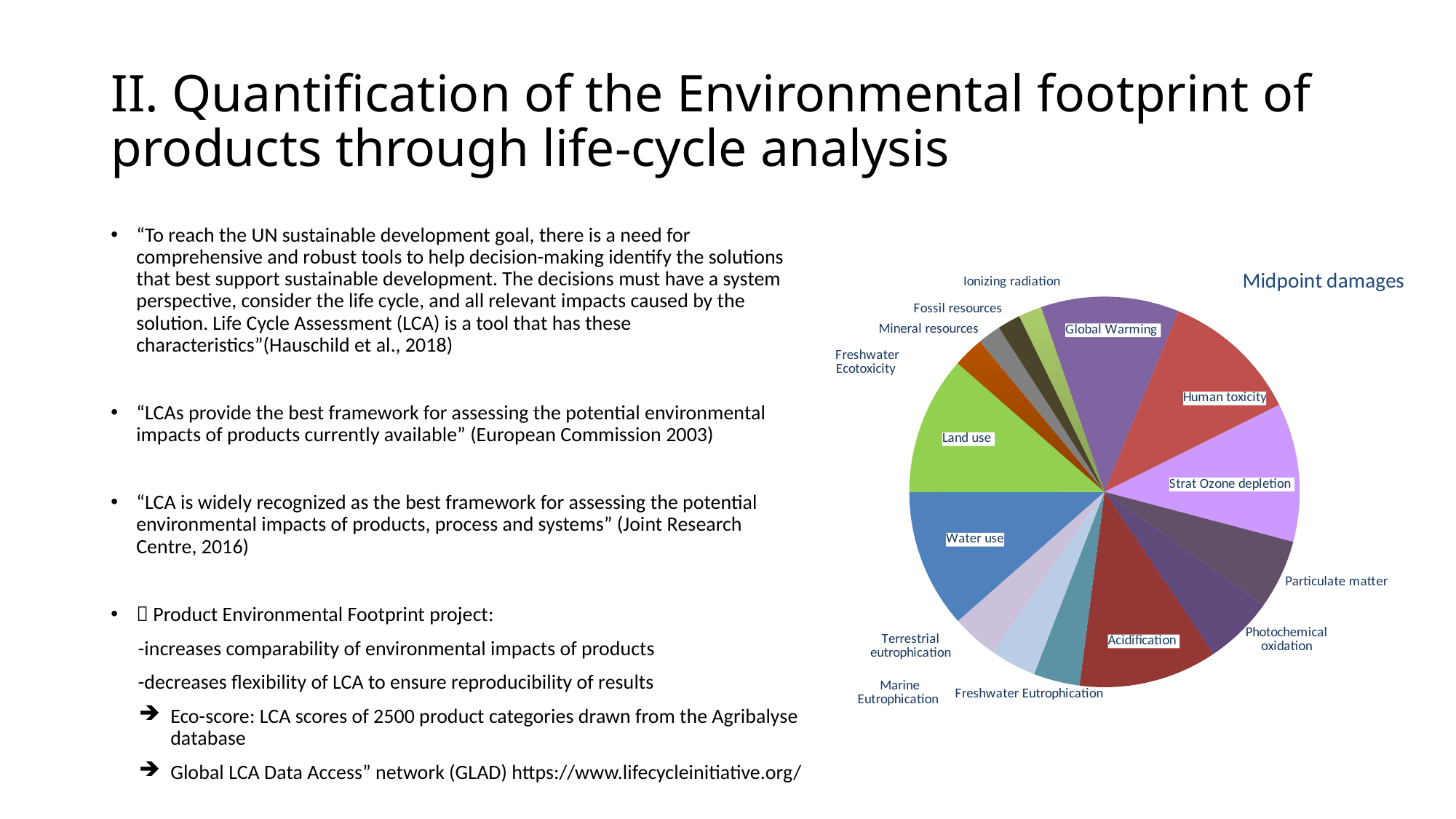
In the Midpoint damages pie chart, which slice is larger: Acidification or Mineral resources? Acidification What colour is the Land use slice in the Midpoint damages pie chart? green In the Midpoint damages pie chart, which slice is larger: Land use or Ionizing radiation? Land use What kind of chart is shown on the slide? pie chart In the Midpoint damages pie chart, which slice is larger: Global Warming or Fossil resources? Global Warming What is the title of the pie chart? Midpoint damages